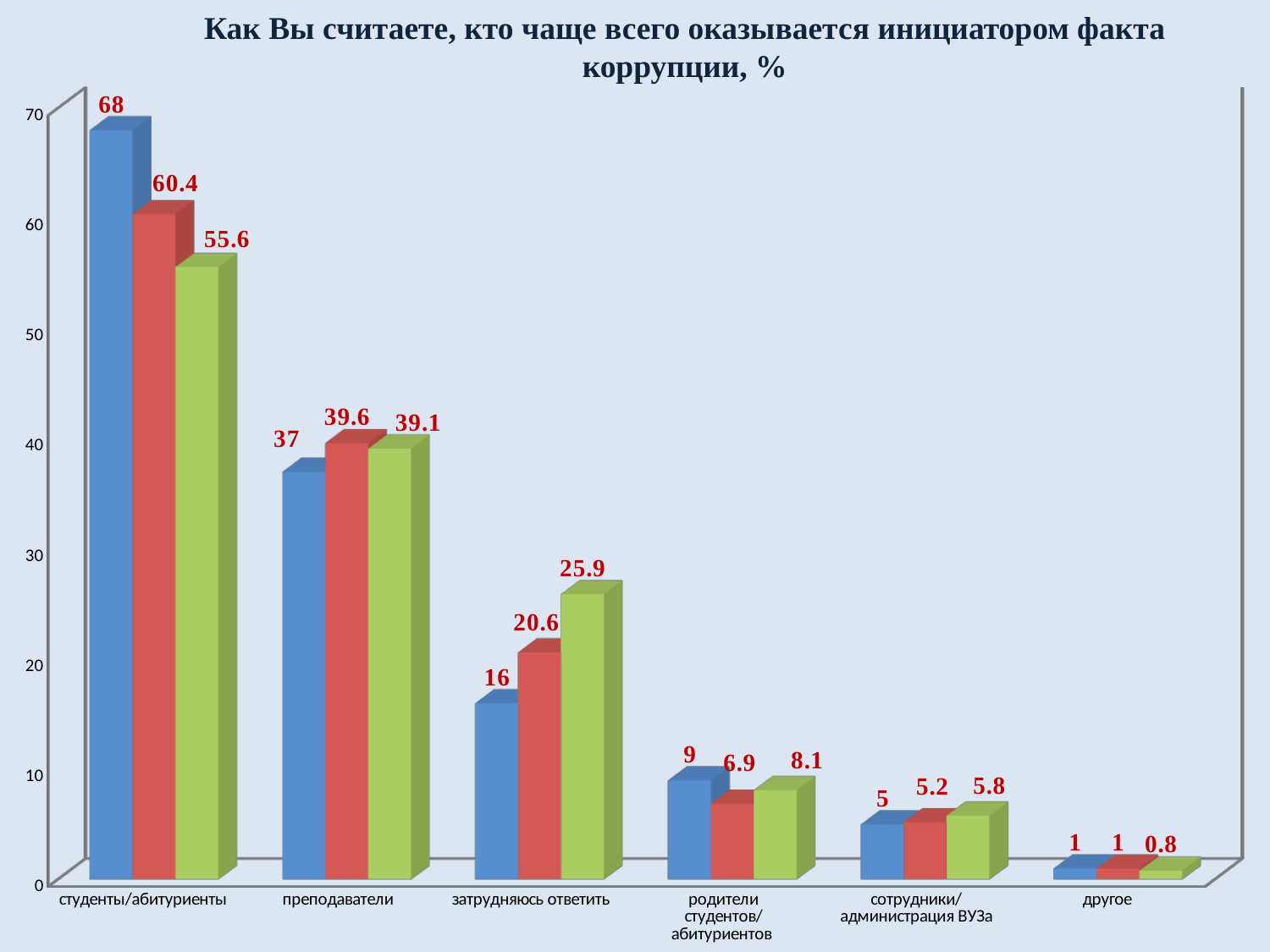
Which category has the highest blue bar? студенты/абитуриенты For затрудняюсь ответить, which is larger: the red bar or the green bar? the green bar What is the value of the blue bar for студенты/абитуриенты? 68 What is the difference between the blue and red bars for студенты/абитуриенты? 7.6 What is the title of the chart? Как Вы считаете, кто чаще всего оказывается инициатором факта коррупции, % What is the value of the red bar for преподаватели? 39.6 Which category has the lowest green bar? другое How many categories are shown on the x axis? 6 What is the value of the green bar for затрудняюсь ответить? 25.9 What type of chart is shown on the slide? bar chart Is the value of the red bar for студенты/абитуриенты greater or less than 60? greater What is the value of the green bar for другое? 0.8